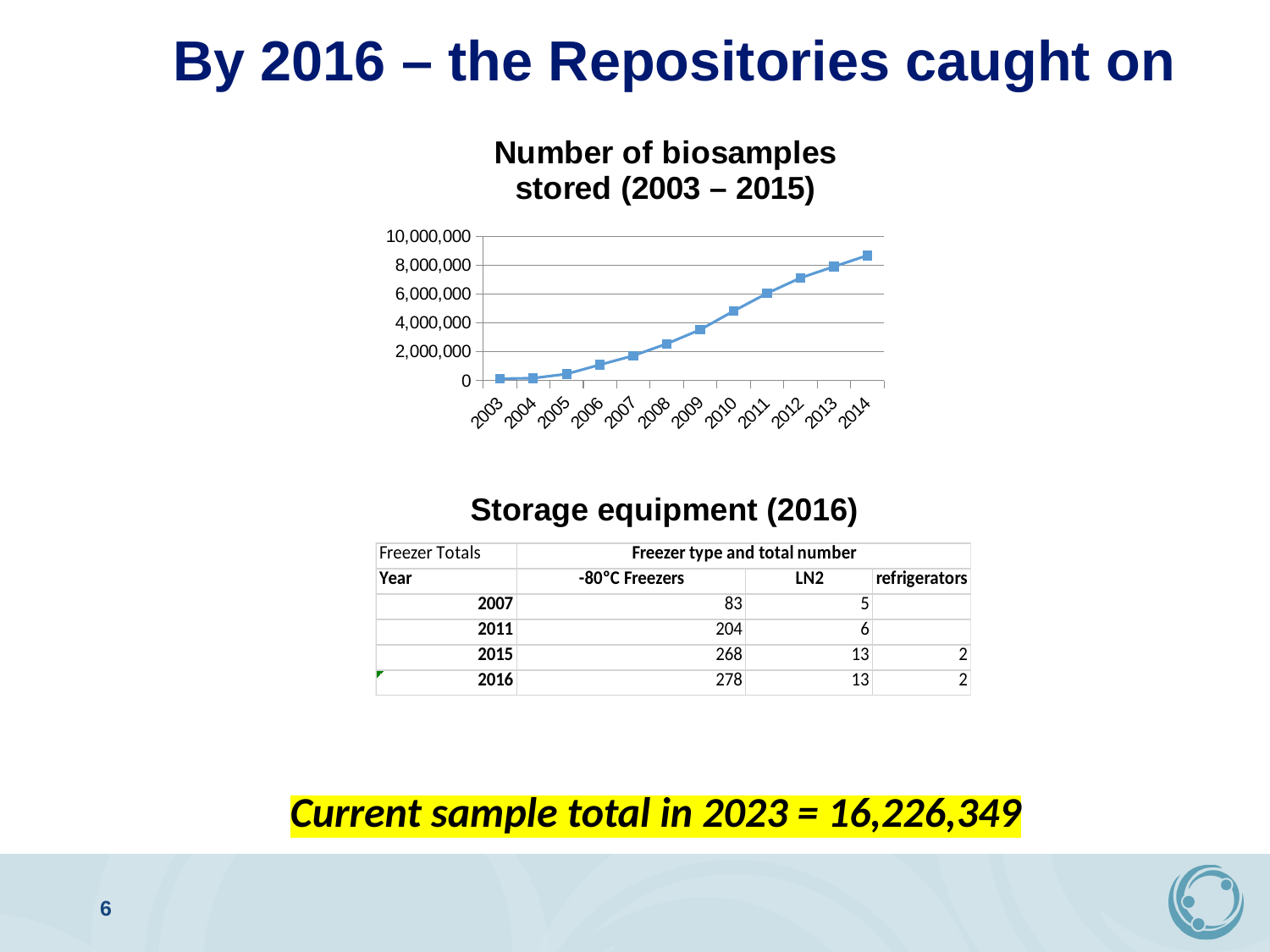
What is the highest tick value shown on the chart's y axis? 10,000,000 Is the value for 2009 greater or less than 4,000,000? less Which year has the highest number of biosamples stored in the chart? 2014 What kind of chart is shown on the slide? line chart What is the title of the chart? Number of biosamples stored (2003 – 2015) Is the value for 2007 greater or less than 2,000,000? less Is the value for 2010 greater or less than 4,000,000? greater How many years are plotted along the x axis of the chart? 12 Do the values in the chart rise or fall from 2003 to 2014? rise Which year has the larger value, 2008 or 2012? 2012